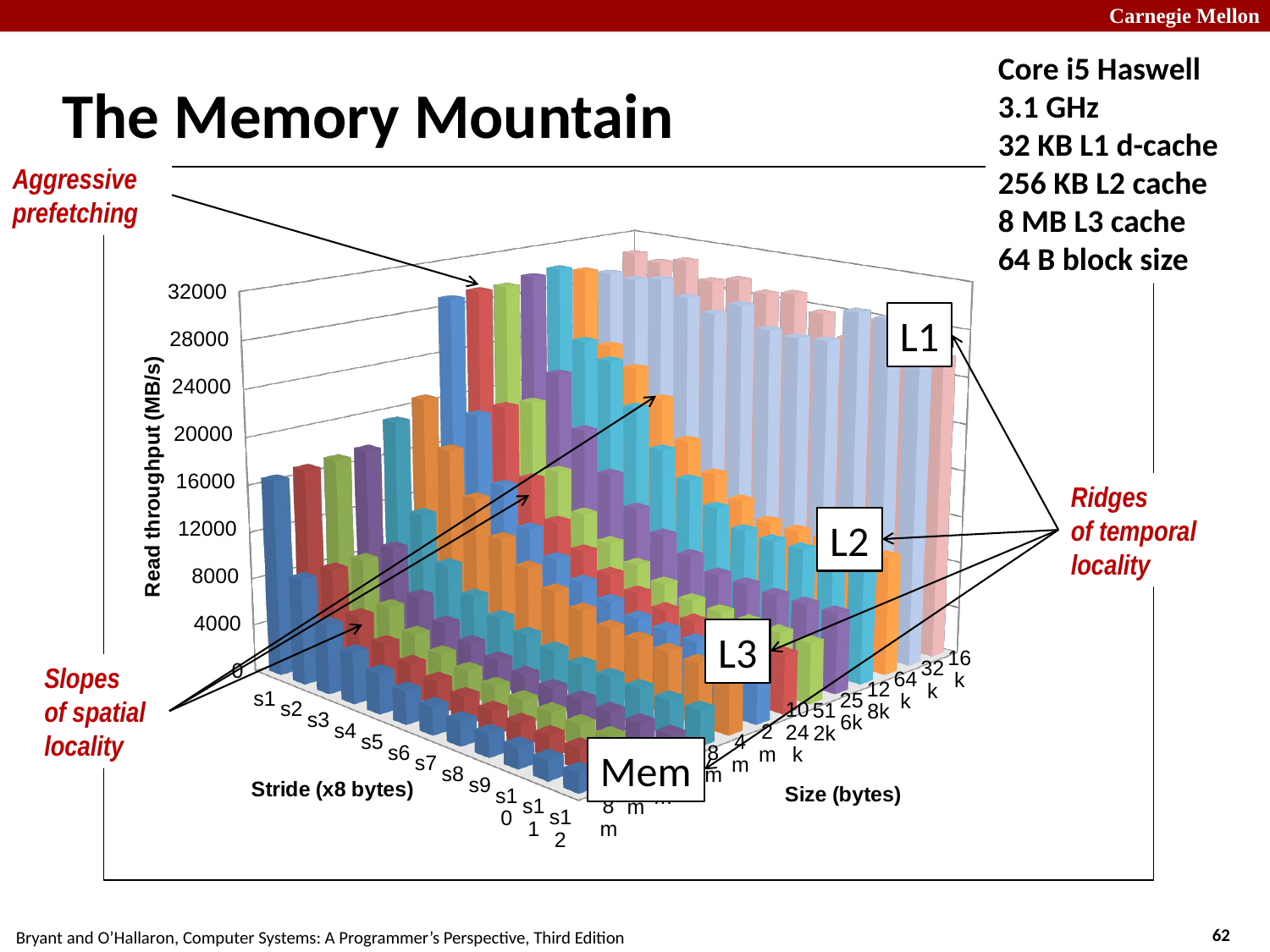
As the stride increases from s1 to s12 for a given size, does read throughput rise or fall? fall Which cache level label is placed at the highest ridge of the chart? L1 What is the label of the vertical axis of the chart? Read throughput (MB/s) How many stride categories (s1 through s12) are shown along the stride axis? 12 What kind of chart is shown on the slide? 3D bar chart What is the label of the stride axis? Stride (x8 bytes) What is the interval between consecutive tick marks on the vertical axis? 4000 What is the highest tick value shown on the vertical axis? 32000